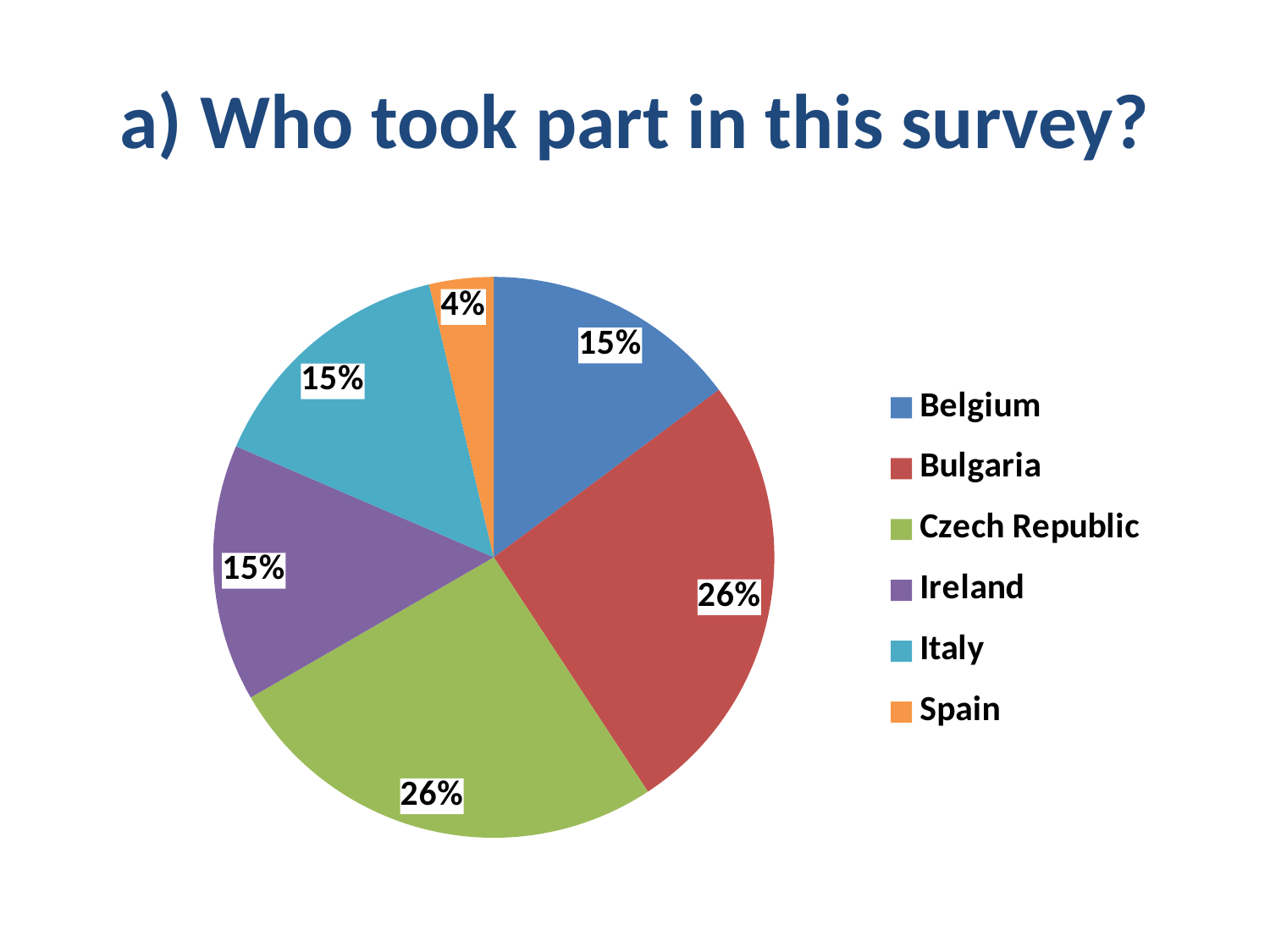
What share of the pie does Spain have? 4% Which is larger, the slice for Czech Republic or the slice for Italy? Czech Republic What is the title of the slide containing the chart? a) Who took part in this survey? What share of the pie does Ireland have? 15% What share of the pie does Belgium have? 15% What kind of chart is shown on the slide? pie chart How many countries are shown in the pie chart? 6 What is the difference between the Bulgaria slice and the Spain slice? 22% Which country has the smallest slice of the pie? Spain What share of the pie does Bulgaria have? 26% How many entries does the legend list? 6 What colour is the slice for Italy? light blue